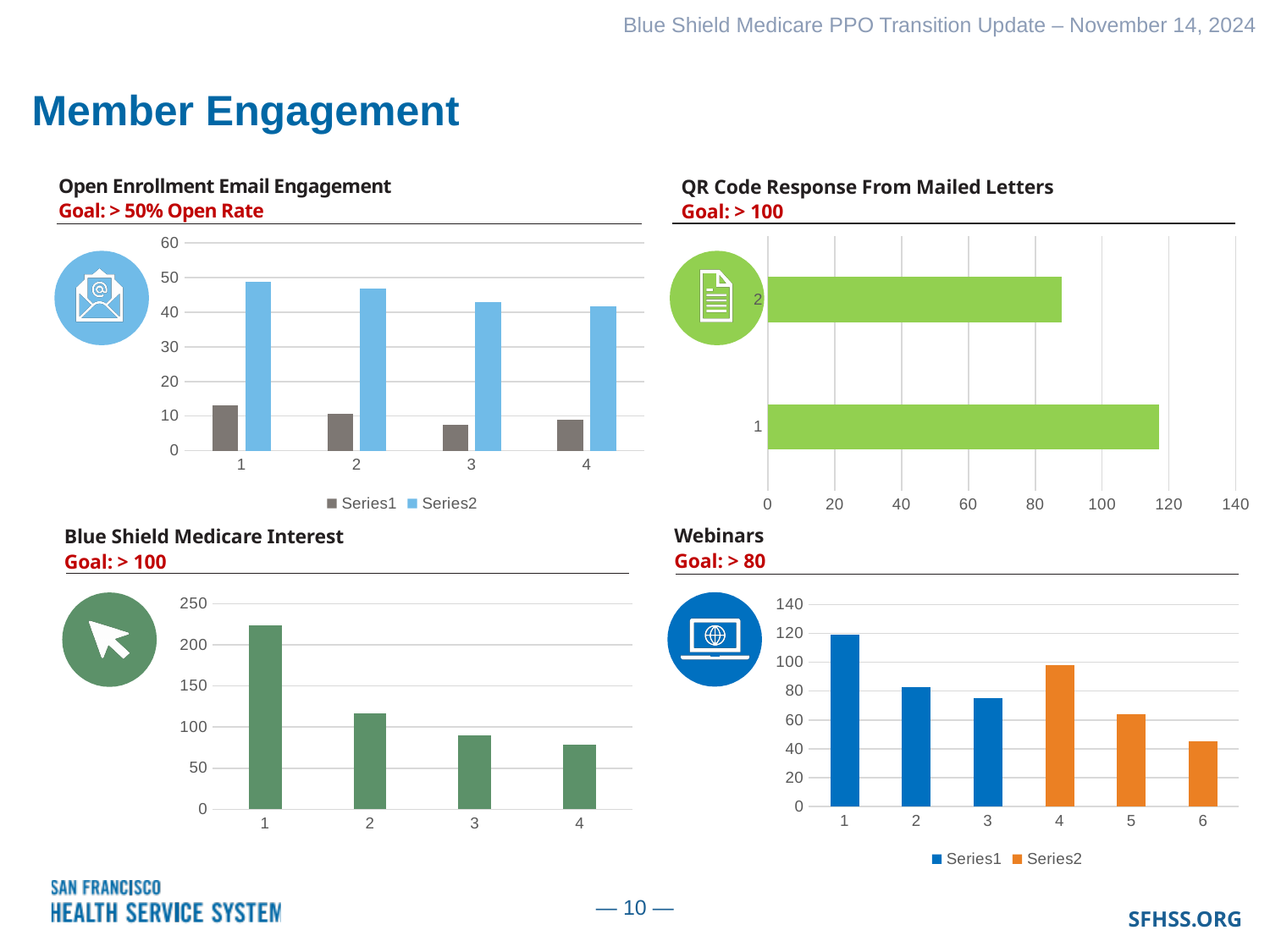
In the Webinars chart, is the value for category 1 greater or less than 100? greater What goal is stated under the Webinars chart title? Goal: > 80 In the Blue Shield Medicare Interest chart, is the value for category 1 greater or less than 200? greater In the Open Enrollment Email Engagement chart, how many series does the legend list? 2 In the Open Enrollment Email Engagement chart, which category has the larger Series2 value, 1 or 4? 1 In the Blue Shield Medicare Interest chart, do the values rise or fall from category 1 to category 4? fall In the QR Code Response From Mailed Letters chart, is the value for category 1 greater or less than 100? greater In the QR Code Response From Mailed Letters chart, which category has the larger value, 1 or 2? 1 In the QR Code Response From Mailed Letters chart, what kind of chart is shown? bar chart In the Webinars chart, which category has the lowest value? 6 In the Webinars chart, how many categories are shown on the x axis? 6 In the Blue Shield Medicare Interest chart, which category has the highest value? 1